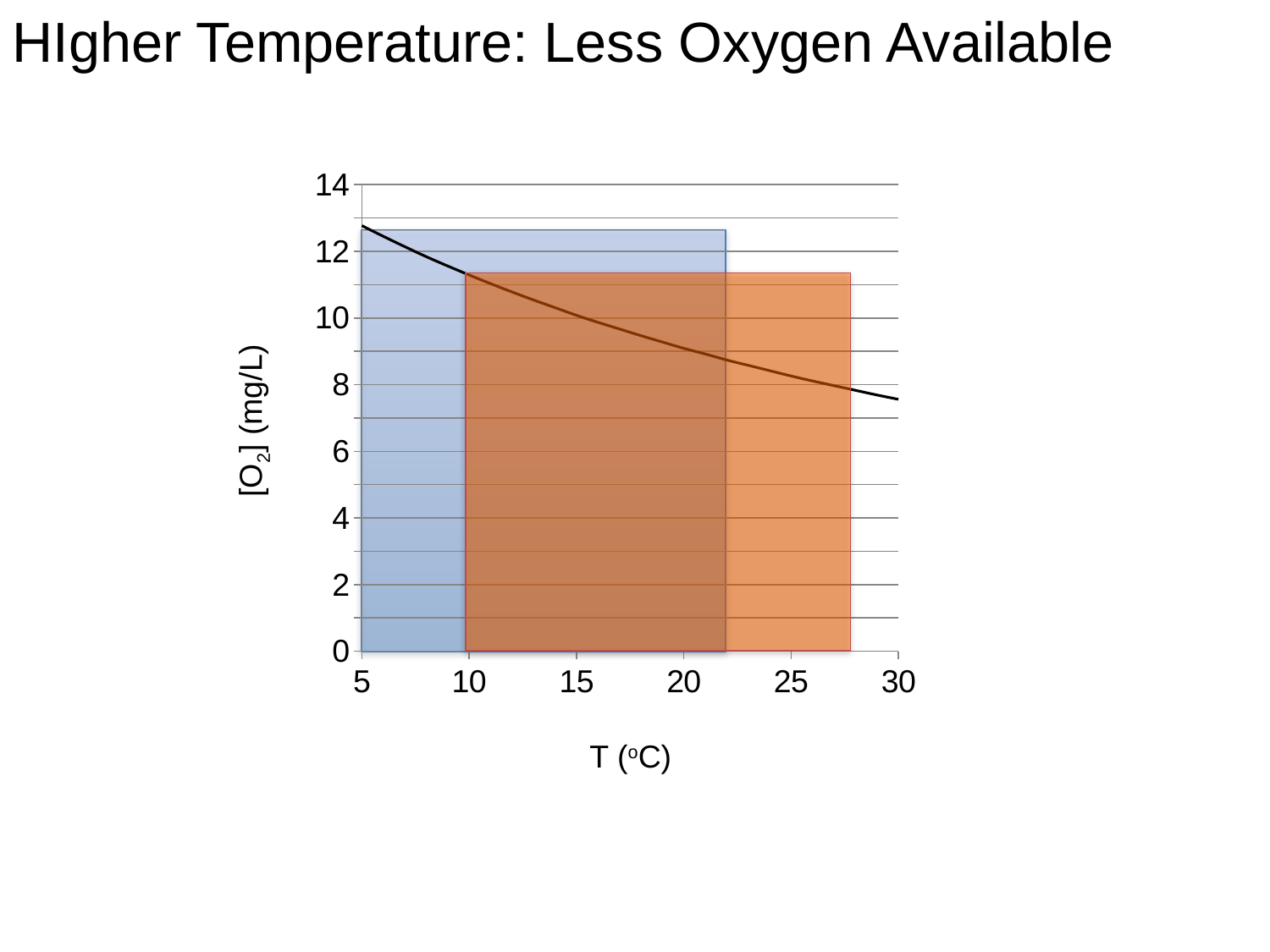
Is the [O2] value at 10 °C greater or less than 10 mg/L? greater What is the label on the x axis of the chart? T (°C) Is the [O2] value at 25 °C greater or less than 6 mg/L? greater At which temperature shown on the x axis is the [O2] value lowest? 30 °C Does the dissolved oxygen concentration rise or fall as temperature increases along the x axis? fall Which has the larger [O2] value, 10 °C or 25 °C? 10 °C Is the [O2] value at 20 °C greater or less than 10 mg/L? less At which temperature shown on the x axis is the [O2] value highest? 5 °C What kind of chart is shown on the slide? line chart What is the title of the slide? HIgher Temperature: Less Oxygen Available